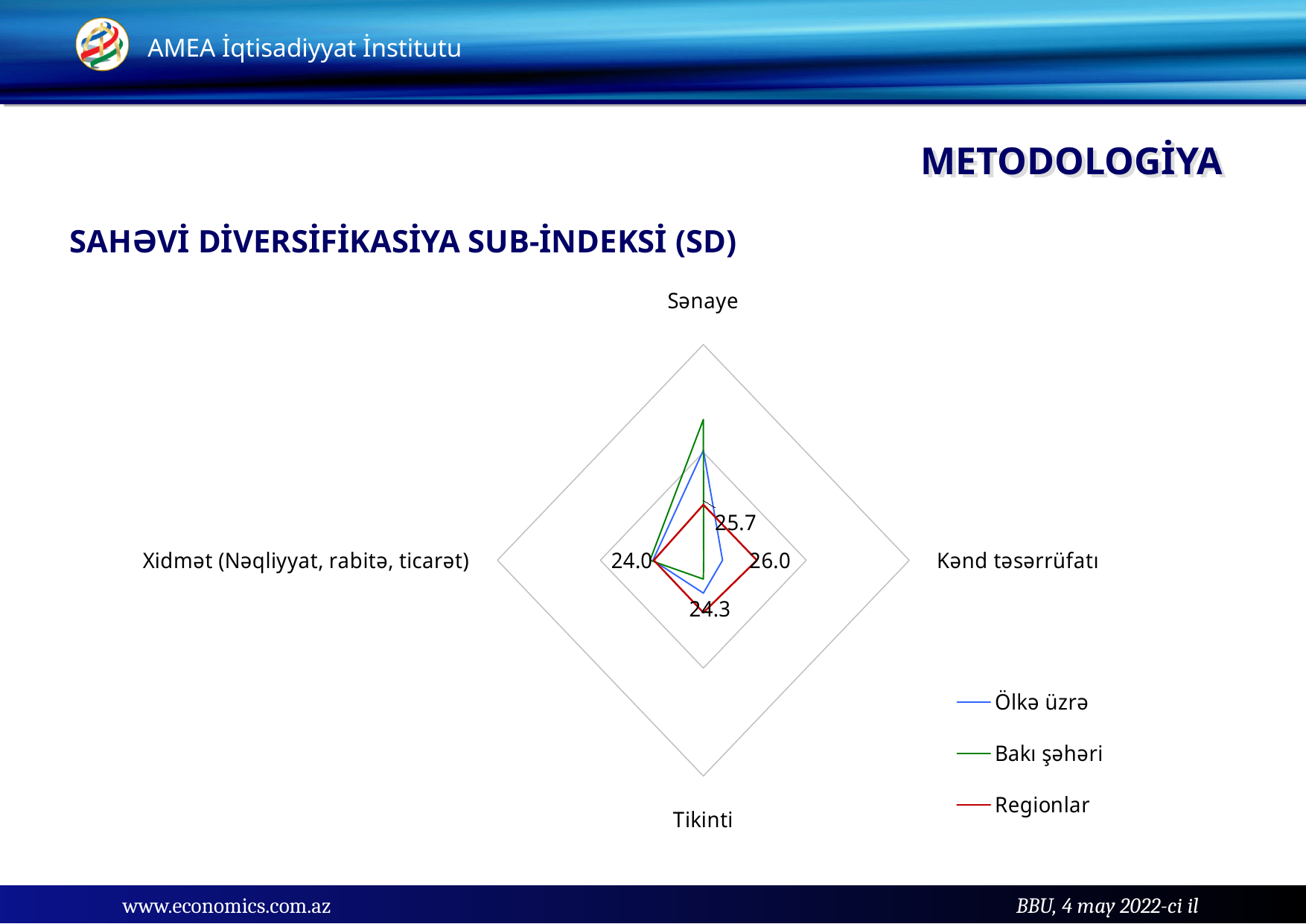
For the Regionlar series, which category has the highest value? Kənd təsərrüfatı What is the difference between the Regionlar values for Kənd təsərrüfatı and Xidmət (Nəqliyyat, rabitə, ticarət)? 2.0 How many categories (axes) does the radar chart have? 4 What is the Regionlar value for Sənaye? 25.7 On the Sənaye axis, which series has the larger value: Bakı şəhəri or Regionlar? Bakı şəhəri For the Regionlar series, which category has the lowest value? Xidmət (Nəqliyyat, rabitə, ticarət) What is the Regionlar value for Xidmət (Nəqliyyat, rabitə, ticarət)? 24.0 How many series does the legend list? 3 What colour is the line for the Regionlar series? red What is the Regionlar value for Tikinti? 24.3 What is the Regionlar value for Kənd təsərrüfatı? 26.0 What kind of chart is shown on the slide? radar chart